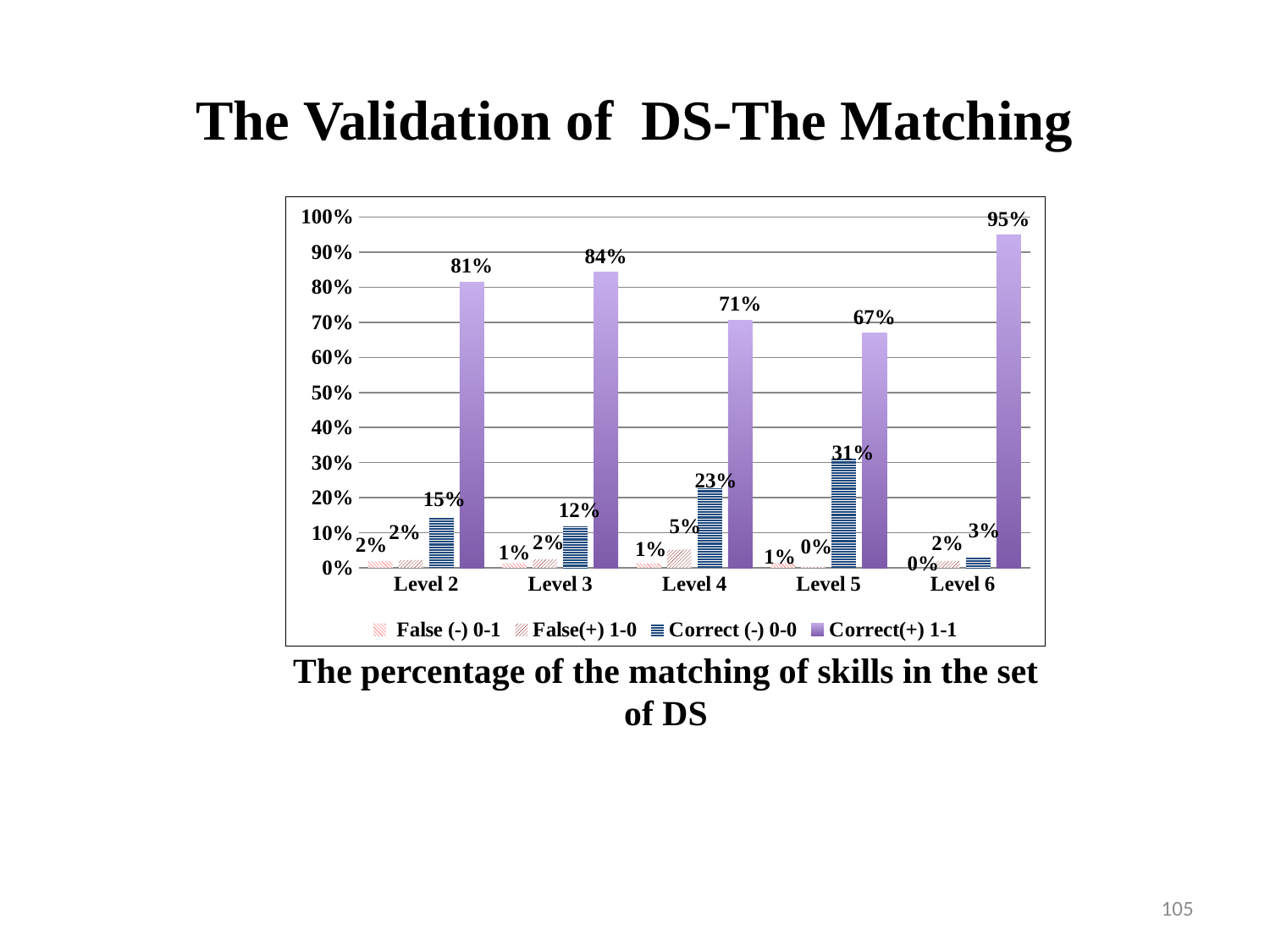
What is the value of Correct (-) 0-0 for Level 5? 31% What is the caption below the chart? The percentage of the matching of skills in the set of DS What is the difference between the Correct(+) 1-1 values for Level 6 and Level 5? 28% What kind of chart is shown on the slide? Bar chart What is the value of Correct(+) 1-1 for Level 4? 71% Which is larger, the Correct (-) 0-0 value for Level 2 or for Level 3? Level 2 How many series does the legend list? 4 What is the value of False(+) 1-0 for Level 4? 5% What is the value of Correct(+) 1-1 for Level 6? 95% Which level has the highest Correct(+) 1-1 value? Level 6 Which level has the lowest Correct(+) 1-1 value? Level 5 How many levels are shown on the x axis? 5